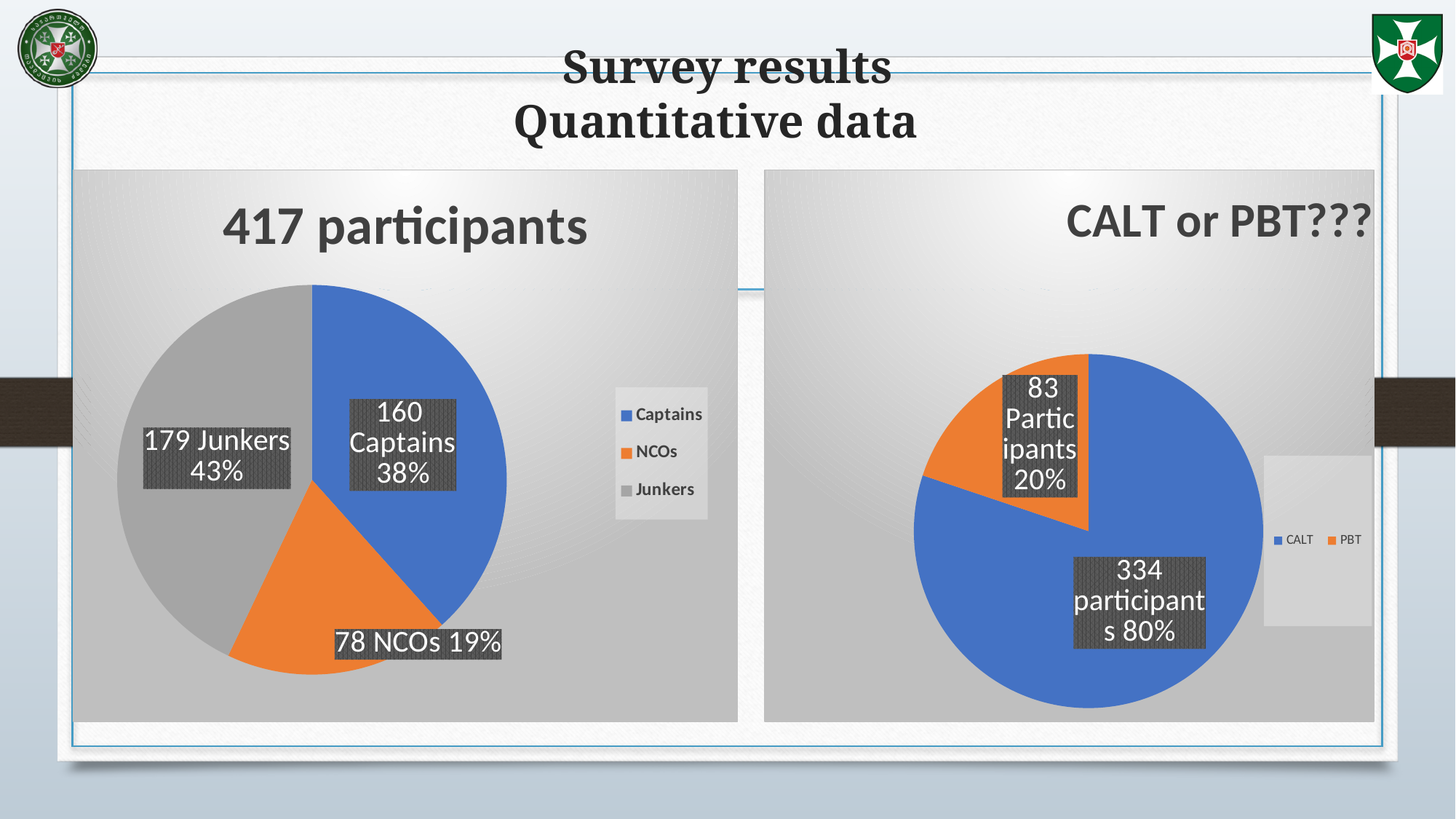
In the 'CALT or PBT???' chart, which option has more participants, CALT or PBT? CALT In the 'CALT or PBT???' chart, what percentage share does PBT have? 20% In the '417 participants' chart, how many NCOs are there? 78 In the '417 participants' chart, how many categories does the legend list? 3 In the 'CALT or PBT???' chart, how many participants chose CALT? 334 In the '417 participants' chart, how many Captains are there? 160 In the '417 participants' chart, what is the difference between the number of Junkers and the number of Captains? 19 In the '417 participants' chart, what percentage share do Junkers have? 43% What kind of chart is the 'CALT or PBT???' chart? Pie chart In the '417 participants' chart, which group has the largest slice? Junkers In the 'CALT or PBT???' chart, what colour is the PBT slice? Orange In the '417 participants' chart, which group has the smallest slice? NCOs